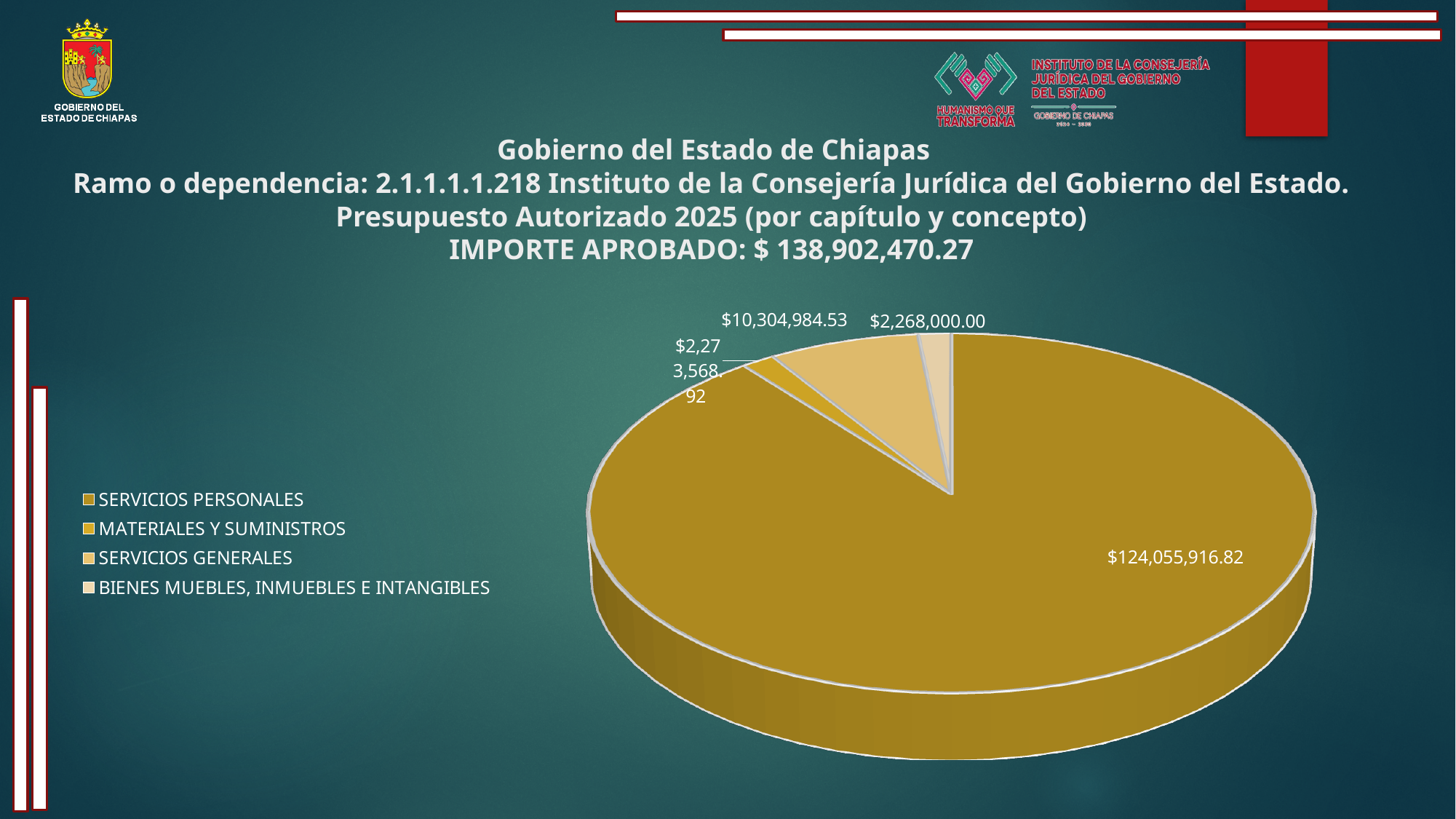
What is the value for BIENES MUEBLES, INMUEBLES E INTANGIBLES? $2,268,000.00 What is the difference between SERVICIOS PERSONALES and SERVICIOS GENERALES? $113,750,932.29 What is the value for MATERIALES Y SUMINISTROS? $2,273,568.92 Which category is listed first in the legend? SERVICIOS PERSONALES How many categories does the legend of the pie chart list? 4 Which is larger, SERVICIOS GENERALES or BIENES MUEBLES, INMUEBLES E INTANGIBLES? SERVICIOS GENERALES What is the difference between SERVICIOS GENERALES and BIENES MUEBLES, INMUEBLES E INTANGIBLES? $8,036,984.53 What type of chart is shown on the slide? Pie chart What is the total approved amount (IMPORTE APROBADO) shown on the slide? $ 138,902,470.27 What is the value for SERVICIOS GENERALES? $10,304,984.53 What is the value for SERVICIOS PERSONALES? $124,055,916.82 Which category has the largest slice of the pie? SERVICIOS PERSONALES